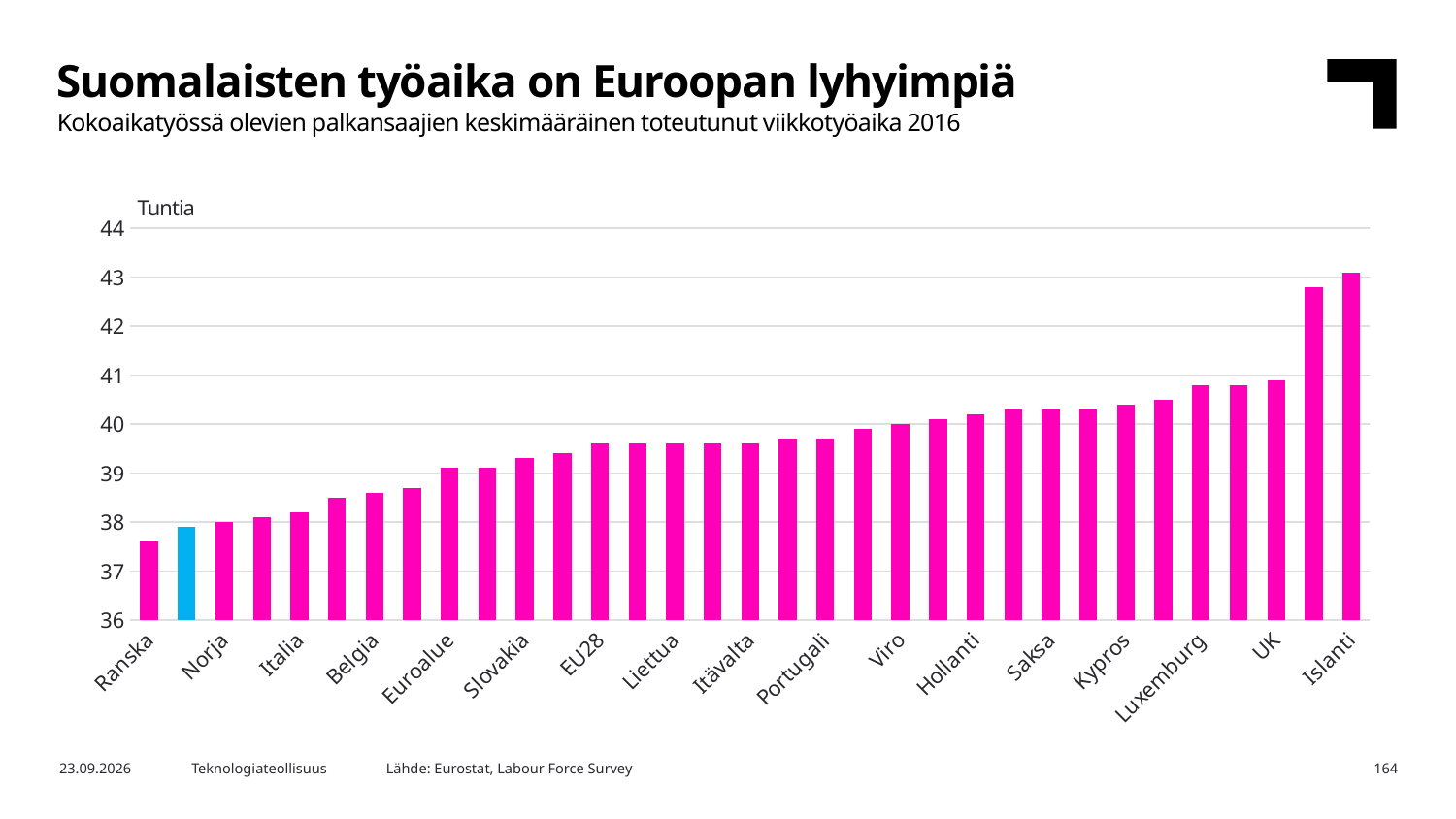
Do the values rise or fall from left to right along the x axis? Rise Is the value for Luxemburg greater or less than 40? greater What kind of chart is shown on the slide? Bar chart Is the value for Ranska greater or less than 38? less What unit is shown on the y axis of the chart? Tuntia Which country has the highest average weekly working time in the chart? Islanti Which labelled country has the lowest average weekly working time in the chart? Ranska Is the value for Belgia greater or less than 39? less Which has a higher value, Belgia or Luxemburg? Luxemburg Which has a higher value, Italia or Saksa? Saksa